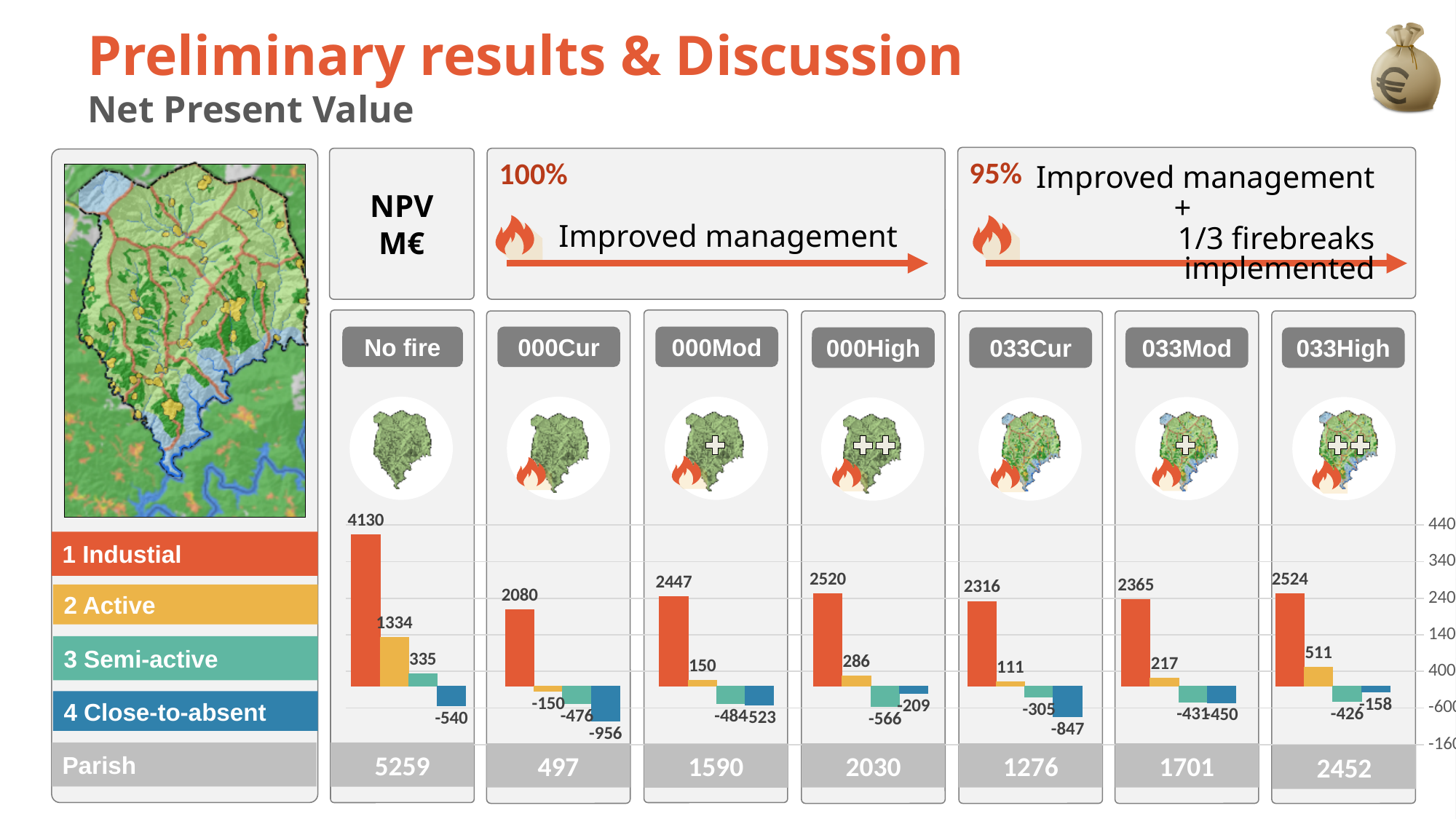
Is the Industrial value in the "033Mod" chart larger or smaller than the Industrial value in the "000Mod" chart? smaller What type of chart is used to show the NPV values for each scenario? bar chart In the "000Cur" chart, what is the value for the Close-to-absent category? -956 In the "No fire" chart, what is the difference between the Industrial value and the Active value? 2796 What colour represents the Close-to-absent category in the charts? blue In the "No fire" chart, what is the NPV value for the Industrial category? 4130 In the "033High" chart, what is the value for the Active category? 511 In the "033Cur" chart, which category has the highest value? 1 Industial How many scenario charts are shown on the slide? 7 In the "000High" chart, which category has the lowest value? 3 Semi-active How many bars are plotted in the "000Mod" chart? 4 In the "033Mod" chart, what is the value for the Semi-active category? -431